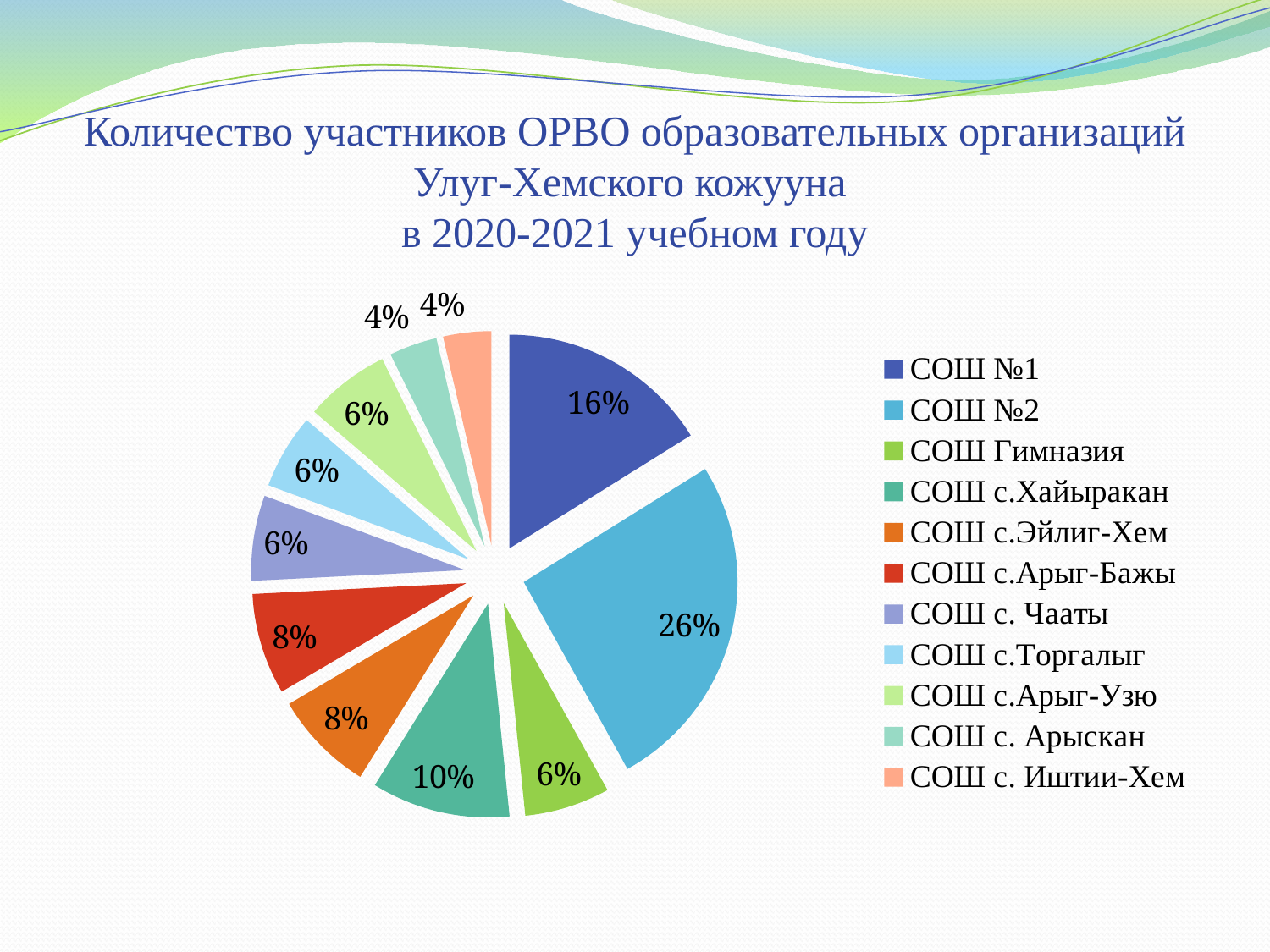
What share of the pie does СОШ №1 have? 16% Which legend entry is shown in red? СОШ с.Арыг-Бажы How many entries does the legend list? 11 Which school has the largest share of the pie? СОШ №2 What share of the pie does СОШ №2 have? 26% What kind of chart is shown on the slide? pie chart Which has a larger share, СОШ с.Хайыракан or СОШ с.Арыг-Бажы? СОШ с.Хайыракан What share of the pie does СОШ с. Арыскан have? 4% What is the difference in percentage points between the shares of СОШ №2 and СОШ №1? 10 How many schools (slices) are shown in the pie chart? 11